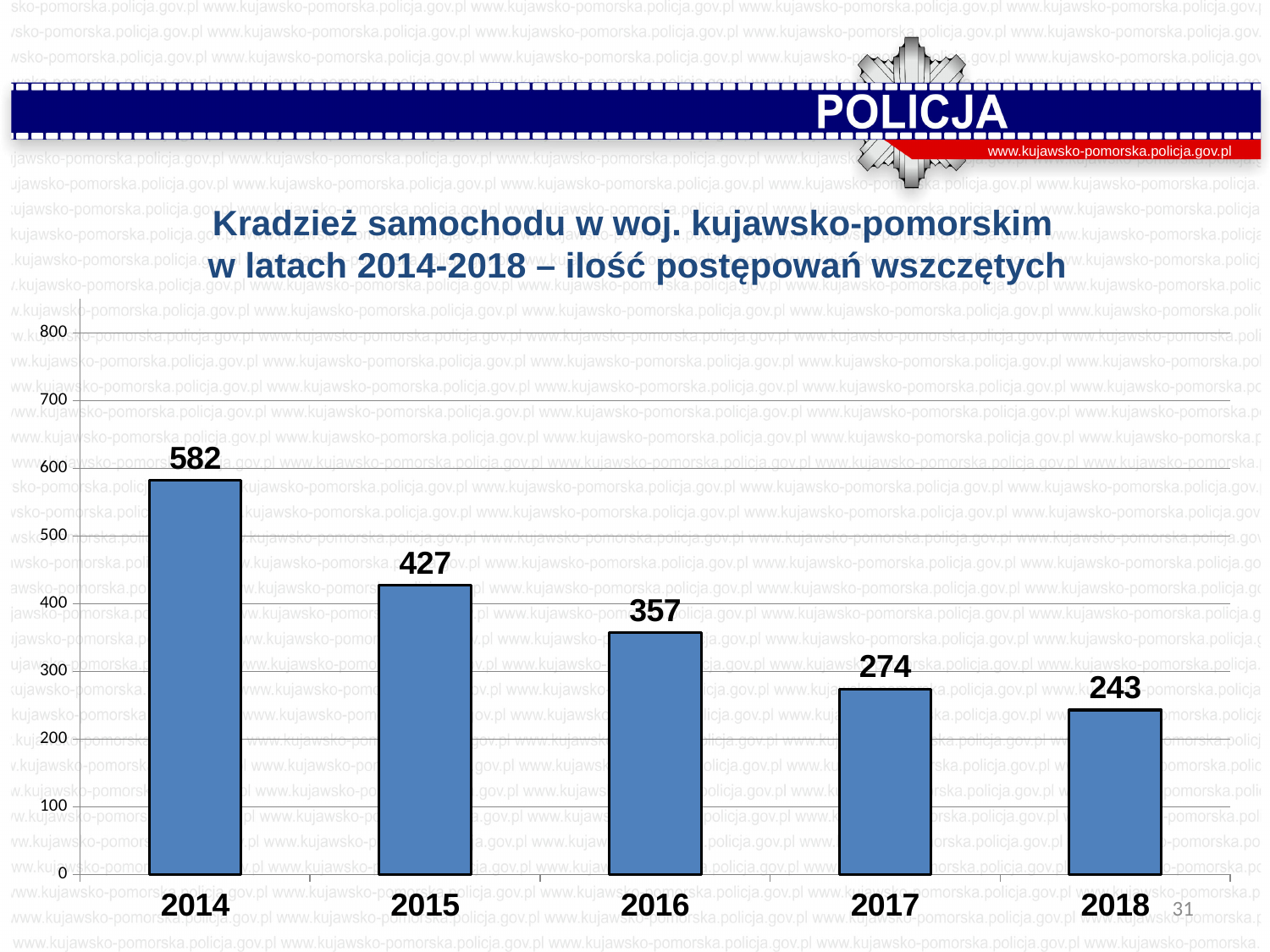
Is the value for 2017 greater or less than 300? less How many years are shown on the x axis? 5 What is the value for 2016? 357 What is the value for 2014? 582 What is the value for 2018? 243 Which is larger, the value for 2015 or the value for 2016? 2015 Which year has the lowest value? 2018 Do the values rise or fall from 2014 to 2018? fall Which year has the highest value? 2014 What is the difference between the values for 2017 and 2018? 31 What is the difference between the values for 2014 and 2015? 155 What kind of chart is shown on the slide? bar chart